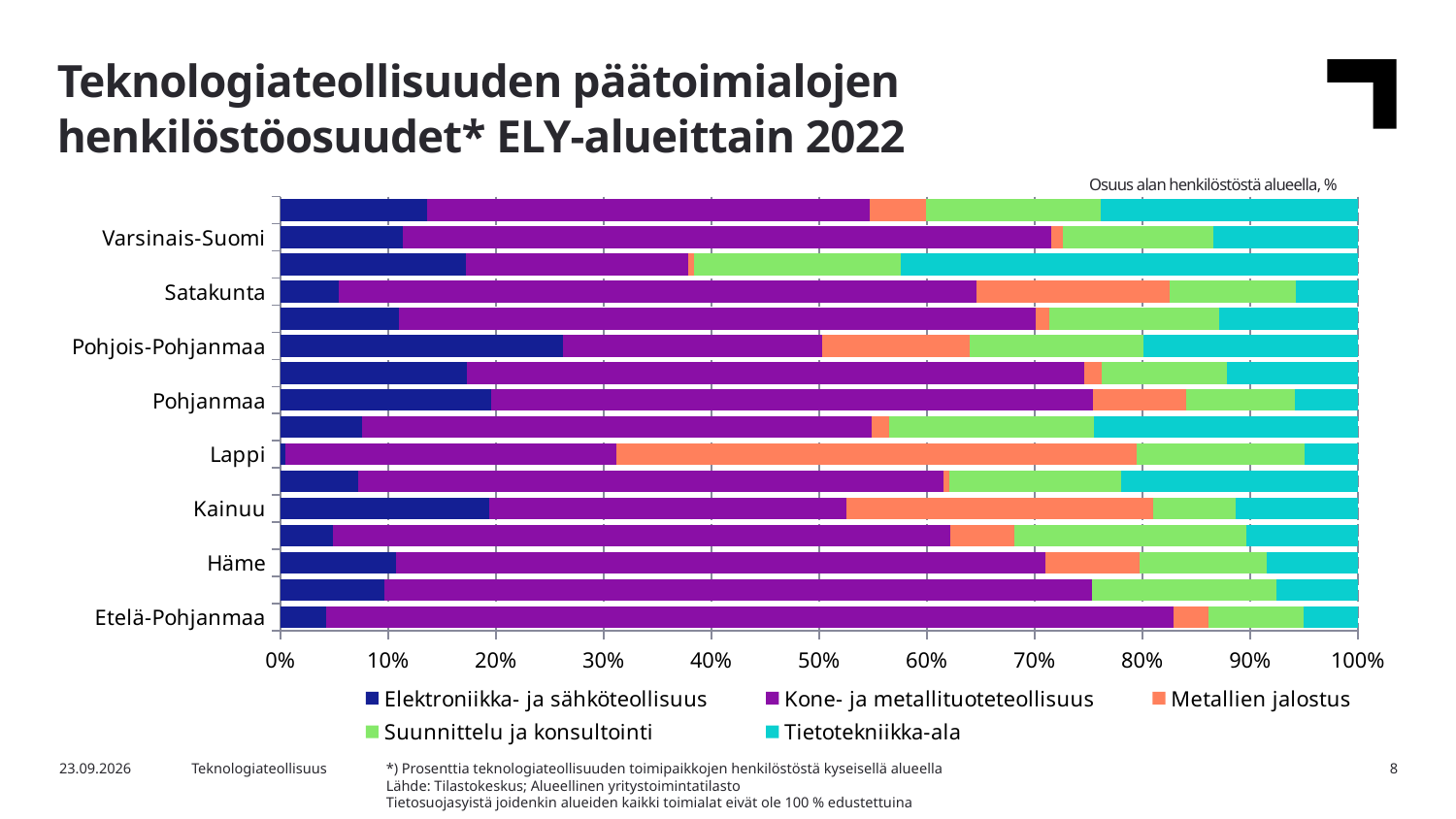
Is the Kone- ja metallituoteteollisuus share for Lappi greater or less than 40%? less What is the title of the chart? Teknologiateollisuuden päätoimialojen henkilöstöosuudet* ELY-alueittain 2022 What does each stacked bar total? 100% Is the Elektroniikka- ja sähköteollisuus share for Pohjois-Pohjanmaa greater or less than 20%? greater Which labelled region has the largest Metallien jalostus share? Lappi How many series does the legend list? 5 Is the Metallien jalostus share for Lappi greater or less than 40%? greater What kind of chart is shown on the slide? Stacked bar chart Which has the larger Elektroniikka- ja sähköteollisuus share, Pohjois-Pohjanmaa or Häme? Pohjois-Pohjanmaa Which series is shown in orange in the legend? Metallien jalostus